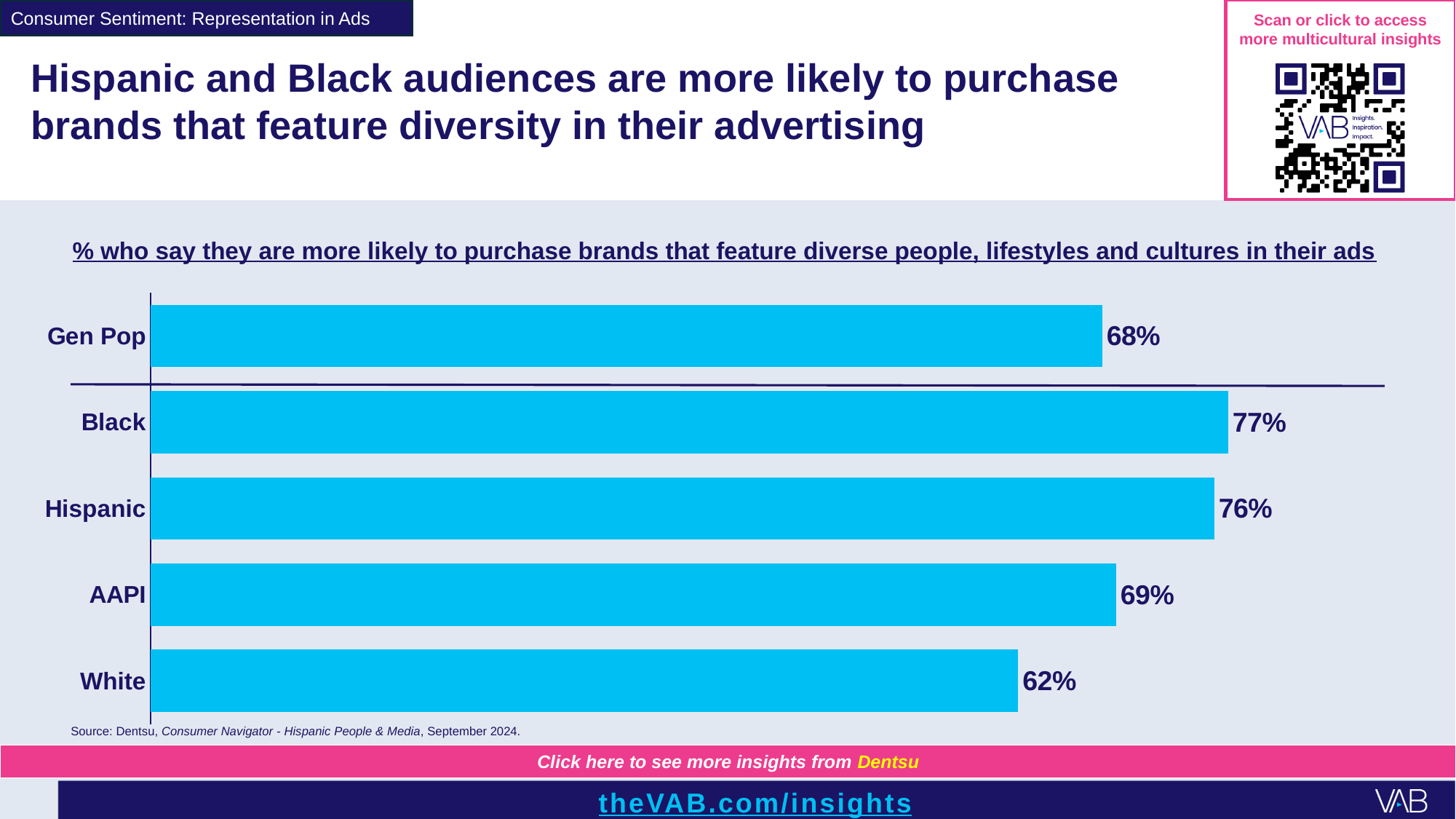
Which group has the lowest percentage in the chart? White What is the value shown for Black audiences in the chart? 77% What colour are the bars in the chart? Light blue What is the difference in percentage points between Black and White audiences? 15 What is the value shown for Hispanic audiences in the chart? 76% What percentage of Gen Pop say they are more likely to purchase brands that feature diverse people, lifestyles and cultures in their ads? 68% Which is larger, the value for AAPI or the value for Gen Pop? AAPI What kind of chart is shown on the slide? Bar chart What is the value shown for White audiences in the chart? 62% How many groups are shown in the chart? 5 Which group has the highest percentage in the chart? Black What is the difference in percentage points between Hispanic and Gen Pop? 8